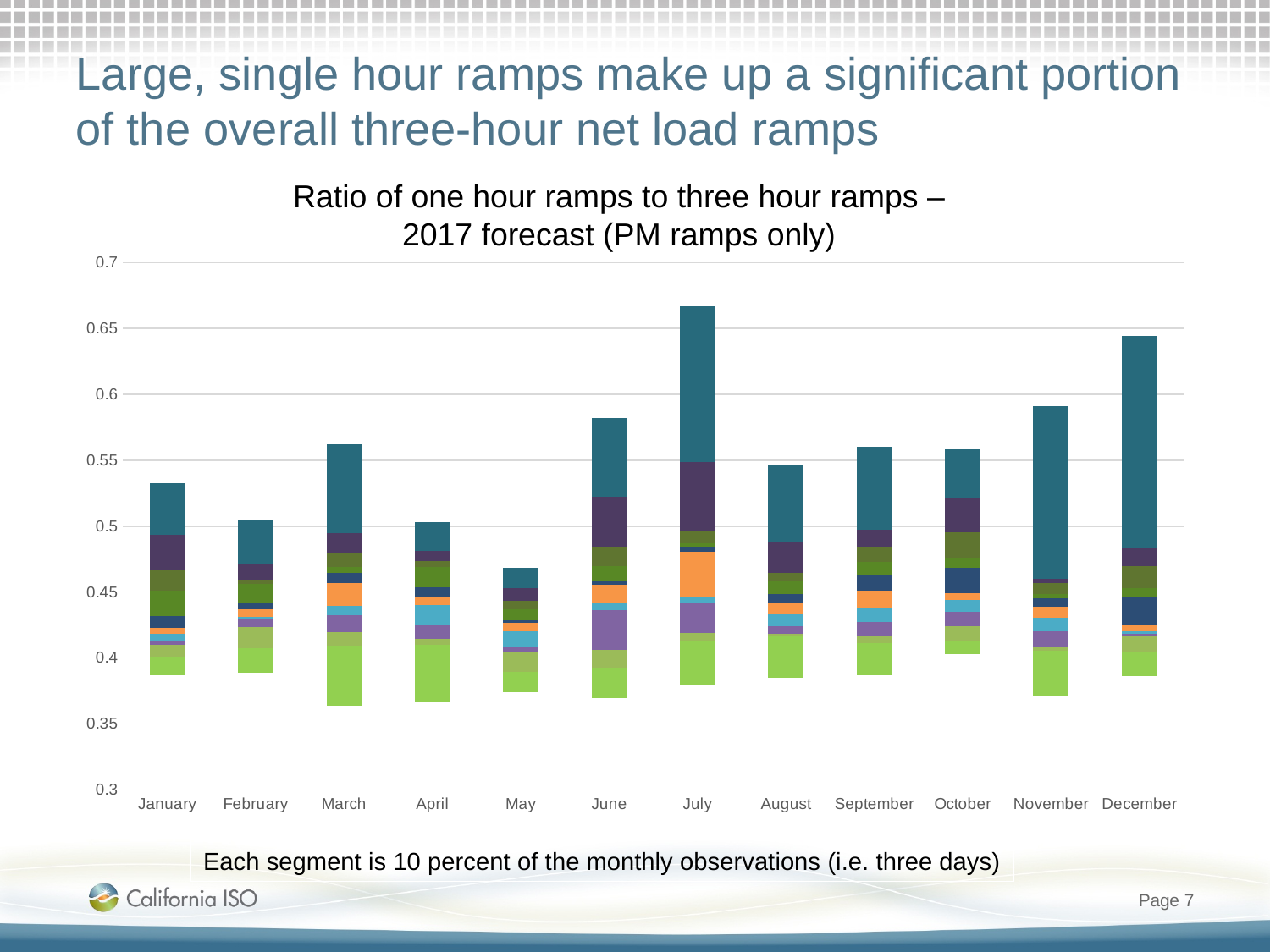
How many months are shown along the x axis of the chart? 12 What kind of chart is shown on the slide? Stacked bar chart Which bar reaches higher, July or May? July Is the top of the December bar greater or less than 0.6? greater Is the top of the May bar greater or less than 0.5? less Which month has the highest top of its stacked bar? July From May to July, do the tops of the bars rise or fall? rise Which bar reaches higher, December or January? December Is the top of the July bar greater or less than 0.65? greater Which month has the lowest top of its stacked bar? May What is the title of the chart? Ratio of one hour ramps to three hour ramps – 2017 forecast (PM ramps only)